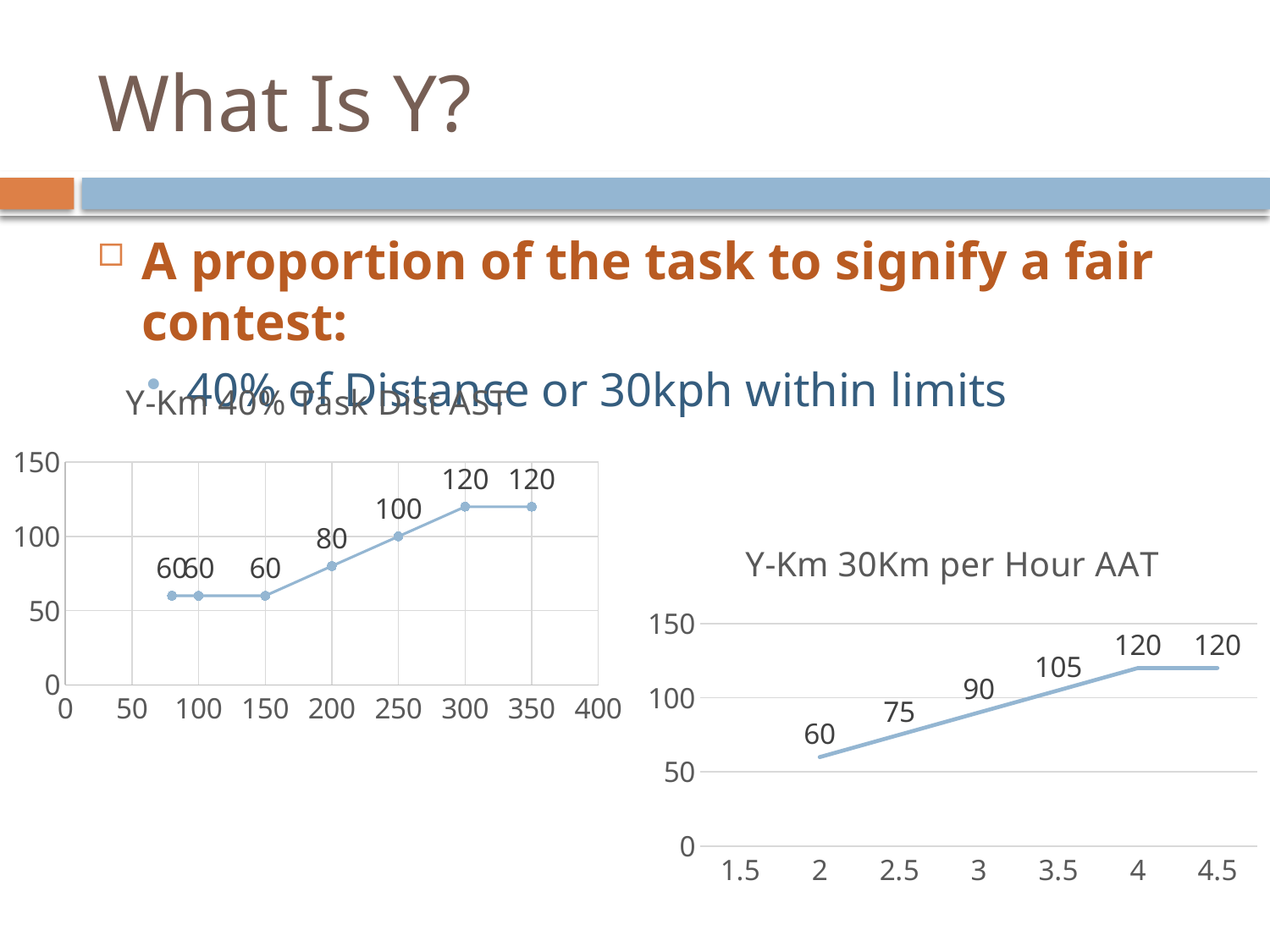
In the right chart titled 'Y-Km 30Km per Hour AAT', what is the value at x = 4.5? 120 In the right chart titled 'Y-Km 30Km per Hour AAT', do the values rise or fall from x = 2 to x = 4? rise In the right chart titled 'Y-Km 30Km per Hour AAT', what is the value at x = 3? 90 In the right chart titled 'Y-Km 30Km per Hour AAT', what is the value at x = 2? 60 In the right chart titled 'Y-Km 30Km per Hour AAT', what is the difference between the value at x = 4 and the value at x = 2? 60 In the left chart, what is the difference between the value at x = 300 and the value at x = 150? 60 In the left chart, what is the value at x = 250? 100 In the left chart, what is the value at x = 300? 120 What is the title of the right chart? Y-Km 30Km per Hour AAT In the right chart titled 'Y-Km 30Km per Hour AAT', how many data points are plotted? 6 What kind of chart is the right chart titled 'Y-Km 30Km per Hour AAT'? line chart In the left chart, what is the value at x = 200? 80